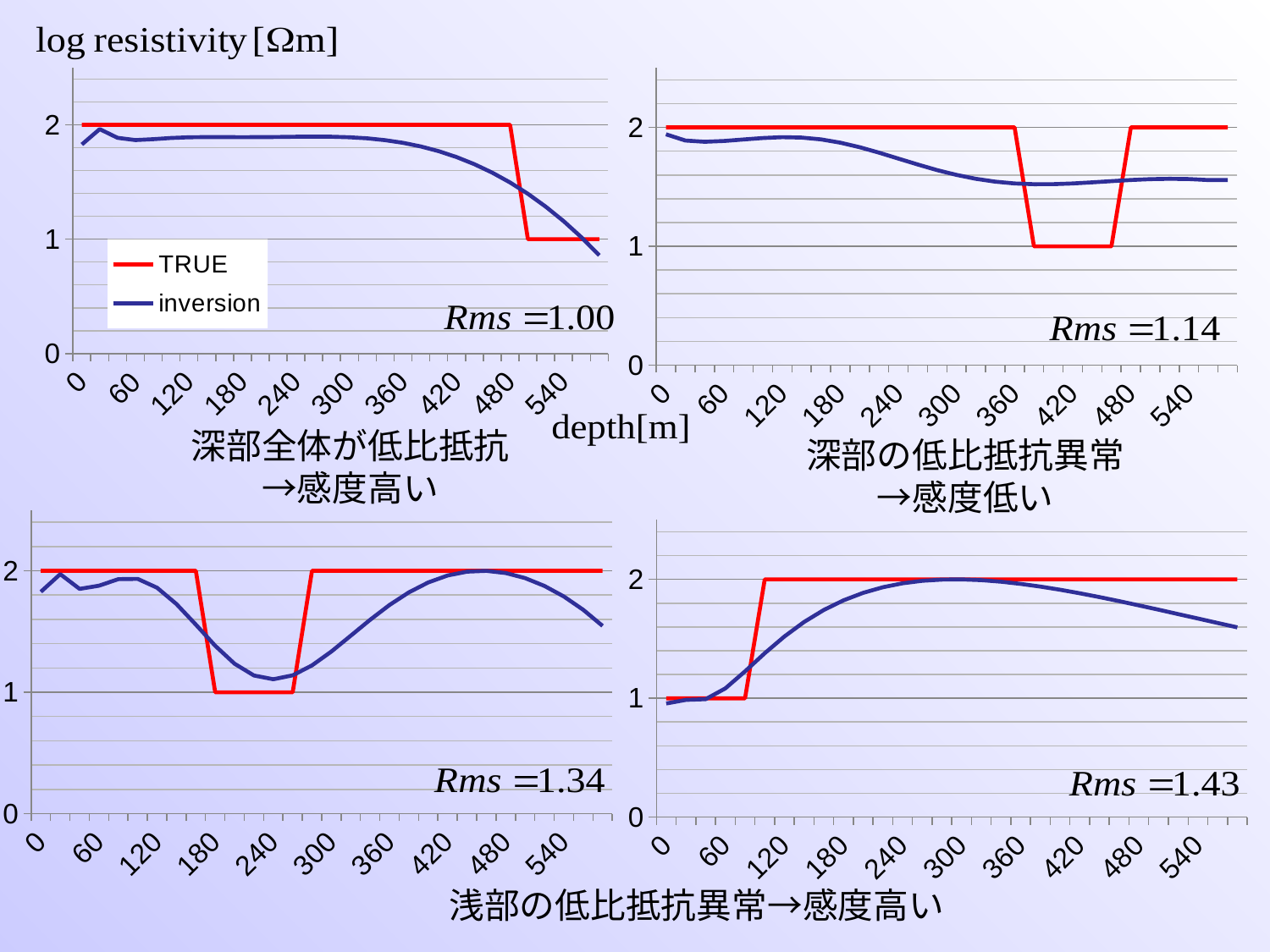
What kind of chart is the top-left chart (Rms = 1.00)? line chart How many series does the legend on the top-left chart list? 2 In the bottom-right chart (Rms = 1.43), is the TRUE value larger at depth 0 or at depth 540? depth 540 In the top-right chart (Rms = 1.14), at depth 420 which series has the higher value, TRUE or inversion? inversion In the top-left chart (Rms = 1.00), what is the difference between the TRUE value at depth 0 and at depth 540? 1 In the bottom-right chart (Rms = 1.43), what is the TRUE value at depth 0? 1 In the top-right chart (Rms = 1.14), what is the TRUE value at depth 0? 2 What Rms value is printed on the top-left chart? 1.00 What Rms value is printed on the bottom-right chart? 1.43 In the bottom-left chart (Rms = 1.34), is the inversion value at depth 240 greater or less than 2? less In the top-right chart (Rms = 1.14), is the inversion value at depth 540 greater or less than 2? less In the top-left chart (Rms = 1.00), what is the TRUE value at depth 540? 1